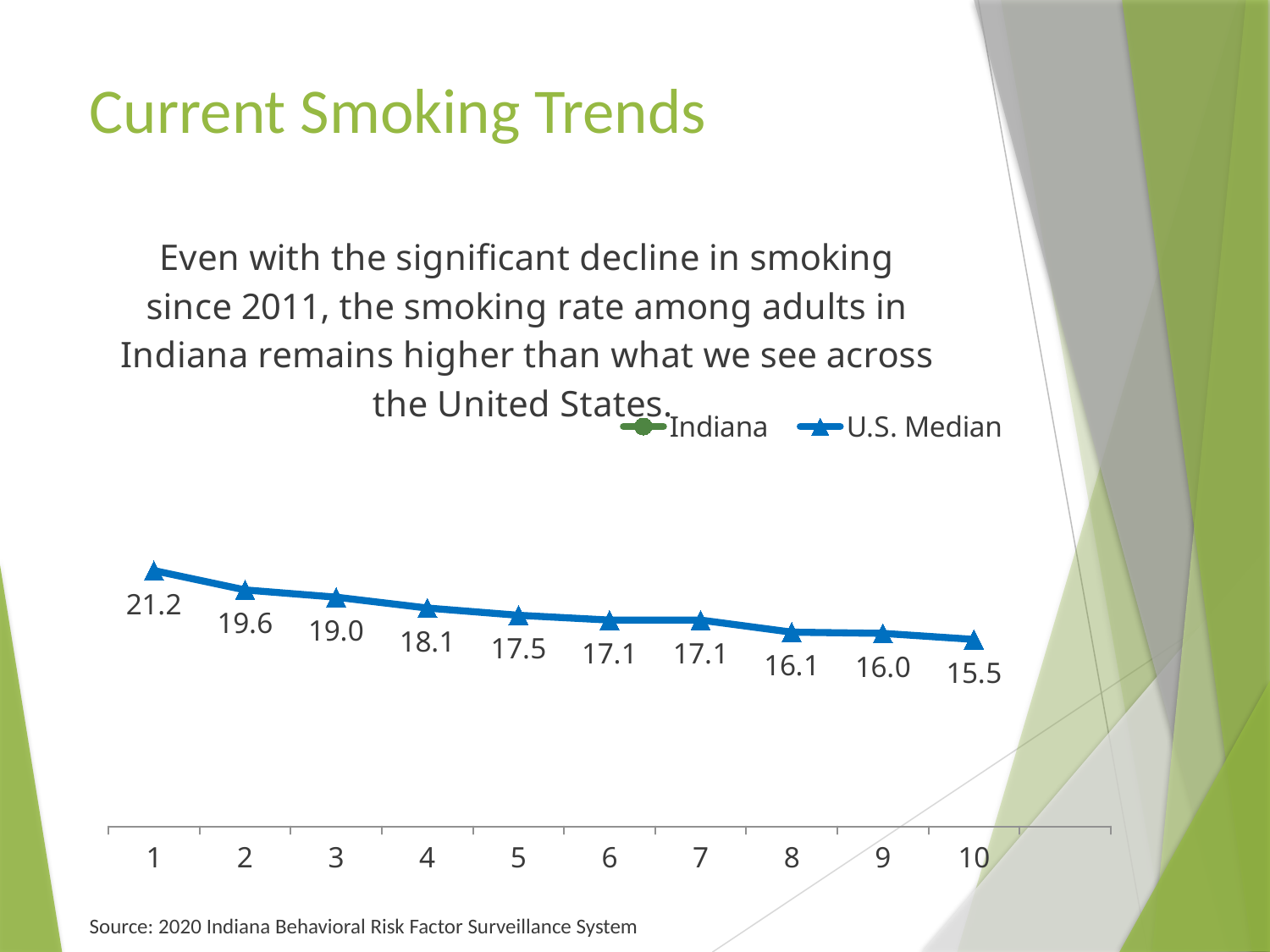
What type of chart is shown on the slide? line chart What is the U.S. Median value at point 10? 15.5 At which x-axis point is the U.S. Median value lowest? 10 At which x-axis point is the U.S. Median value highest? 1 What is the U.S. Median value at point 4? 18.1 Do the U.S. Median values rise or fall from point 1 to point 10? fall Which is larger, the U.S. Median value at point 2 or at point 5? point 2 What is the difference between the U.S. Median value at point 1 and at point 10? 5.7 How many series does the chart legend list? 2 What is the U.S. Median value at point 1? 21.2 How many data points are plotted along the x axis? 10 What is the U.S. Median value at point 8? 16.1